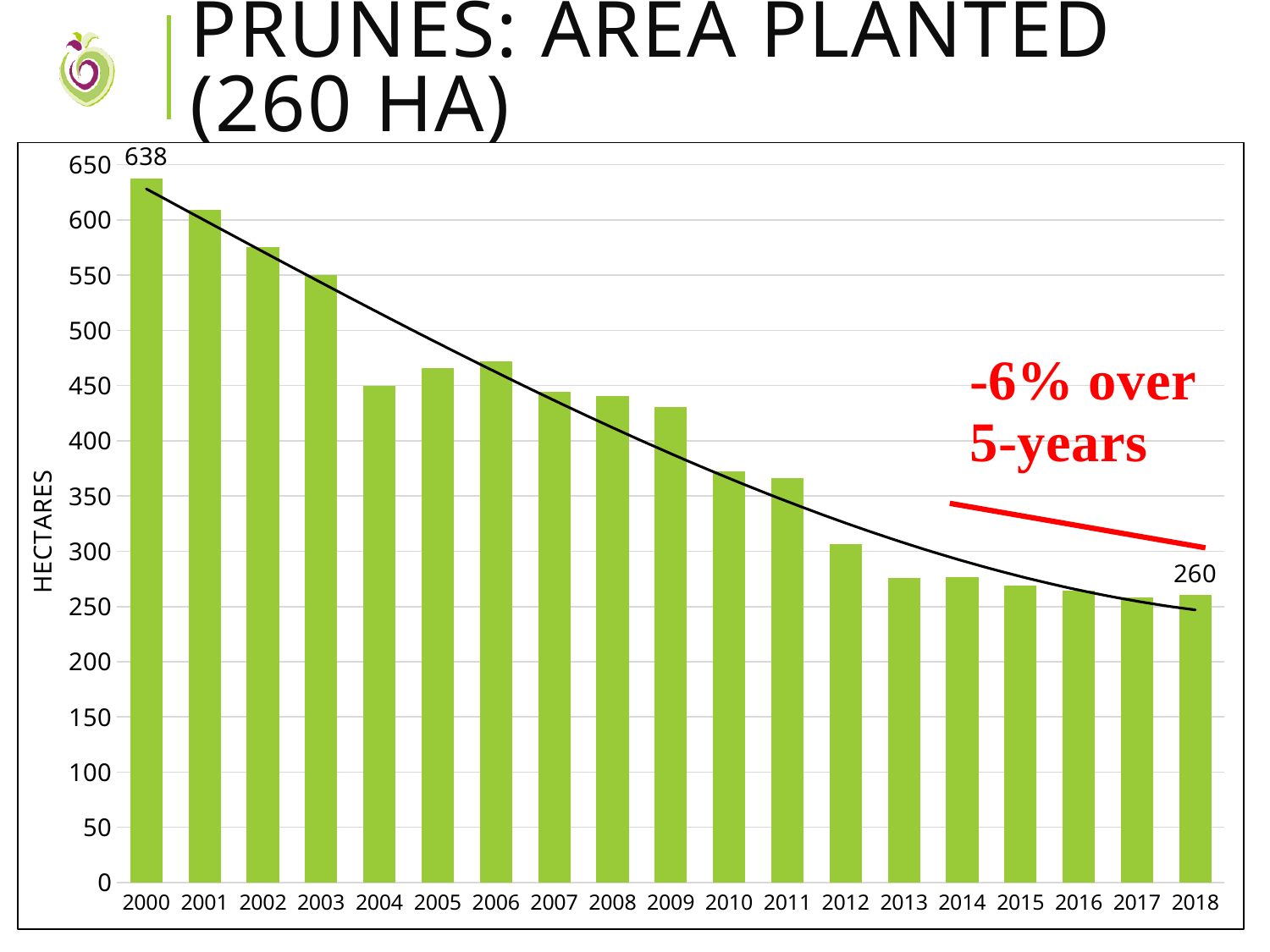
What is the label on the y axis? HECTARES Do the values generally rise or fall from 2000 to 2018? fall Is the value for 2003 greater or less than 500? greater What kind of chart is shown on the slide? bar chart What was the area planted with prunes in 2018? 260 Is the value for 2004 greater or less than 400? greater What was the area planted with prunes in 2000? 638 Which year has the largest area planted? 2000 Is the value for 2012 greater or less than 350? less By how many hectares did the area planted fall between 2000 and 2018? 378 How many years are shown on the x axis? 19 Which year has the larger area planted, 2001 or 2005? 2001